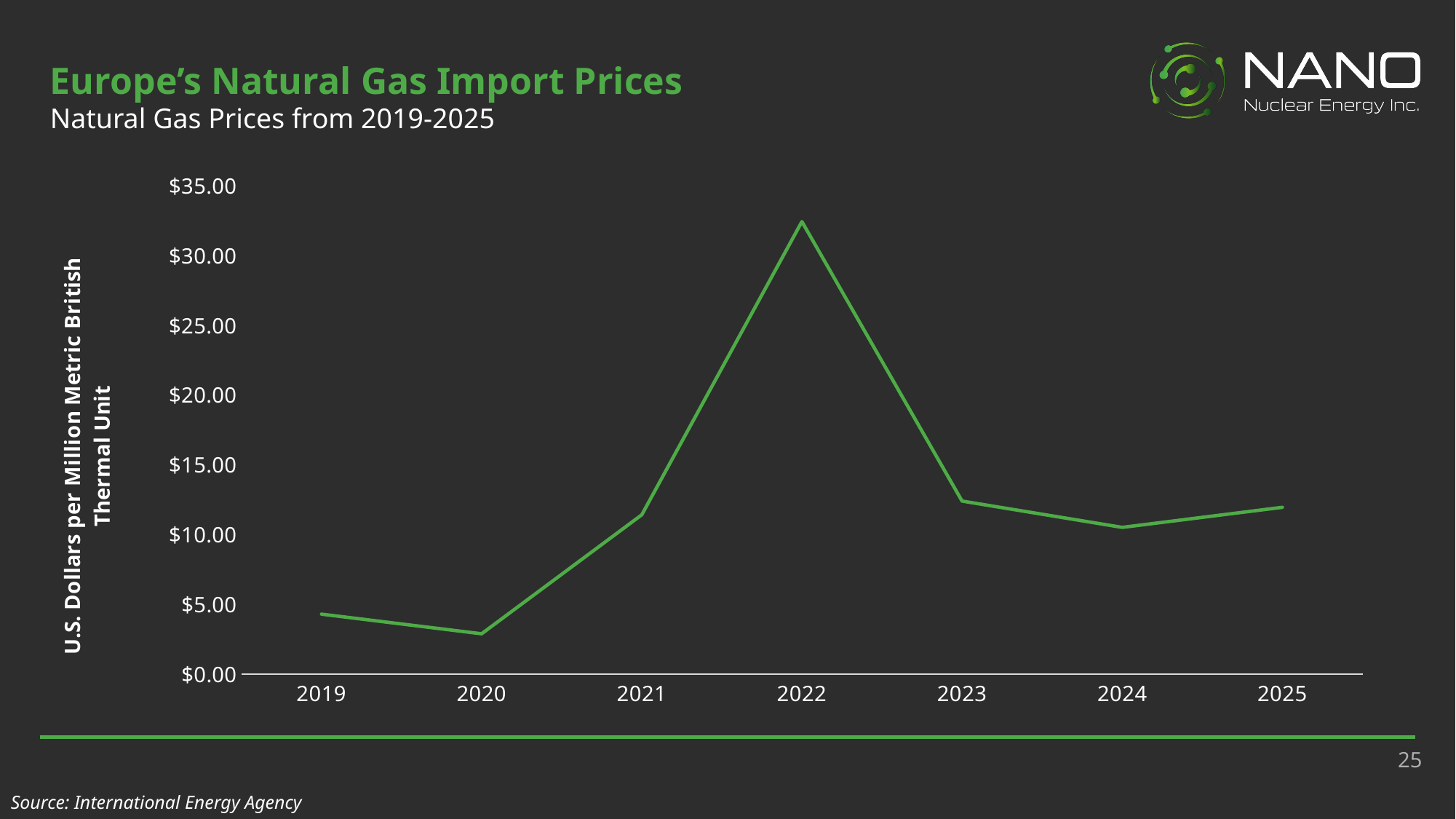
Do prices rise or fall from 2022 to 2023? fall What kind of chart is shown on the slide? line chart Which year has the highest natural gas import price? 2022 Is the value for 2020 greater or less than $5.00? less Which year has a higher price, 2019 or 2020? 2019 Is the value for 2022 greater or less than $30.00? greater Is the value for 2021 greater or less than $10.00? greater Which year has the lowest natural gas import price? 2020 How many years are plotted on the x axis? 7 Which year has a higher price, 2022 or 2023? 2022 What is the label on the vertical axis? U.S. Dollars per Million Metric British Thermal Unit